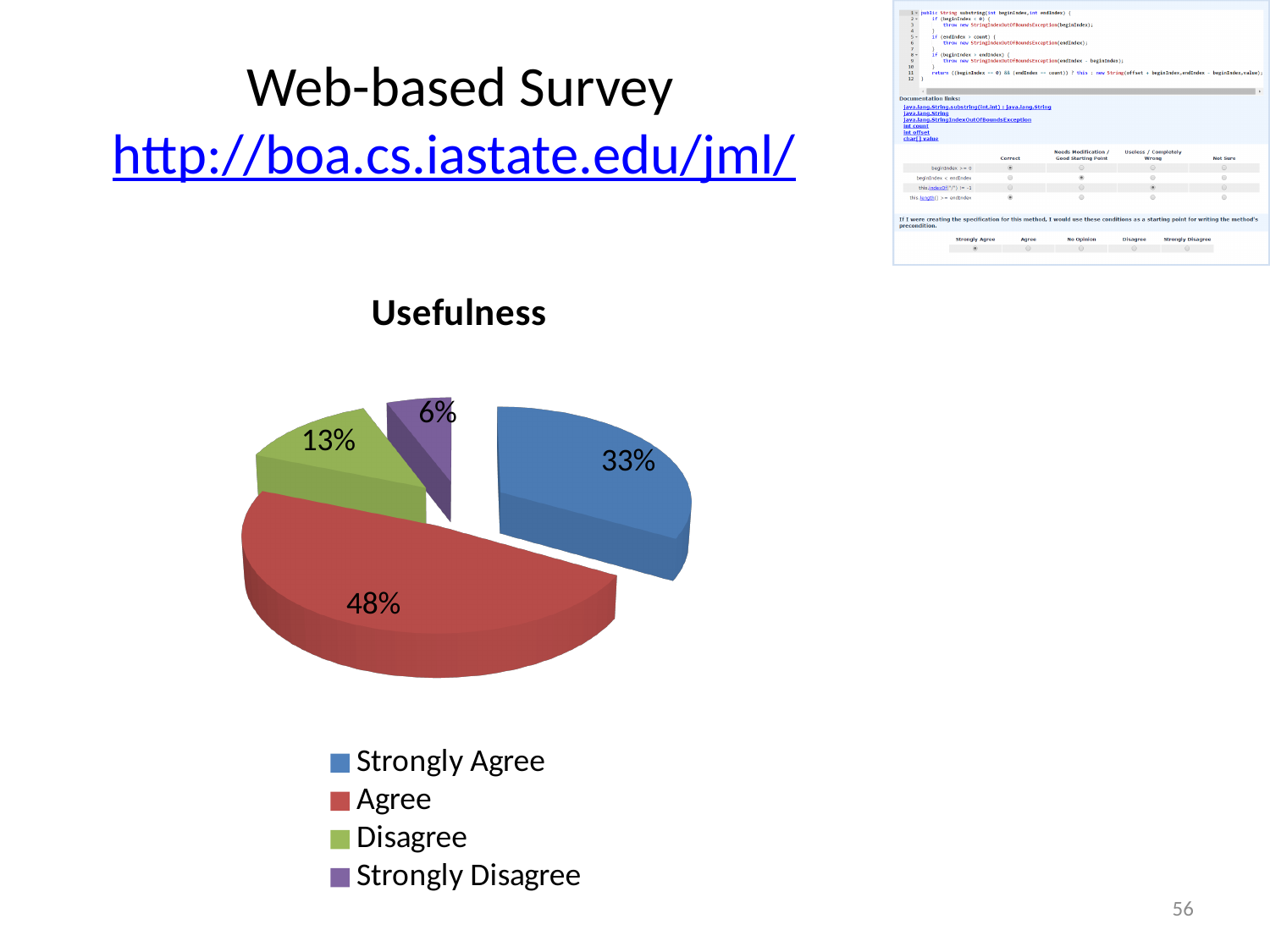
Which category has the largest slice of the pie? Agree What is the difference in percentage points between the "Agree" and "Strongly Agree" slices? 15% What share of the pie is labelled "Agree"? 48% What share of the pie is labelled "Strongly Disagree"? 6% What kind of chart is shown under the title "Usefulness"? pie chart Which category has the smallest slice of the pie? Strongly Disagree What is the chart's title? Usefulness How many categories does the legend list? 4 Which slice is larger, "Disagree" or "Strongly Disagree"? Disagree What share of the pie is labelled "Disagree"? 13% What colour is the "Agree" slice in the legend? red